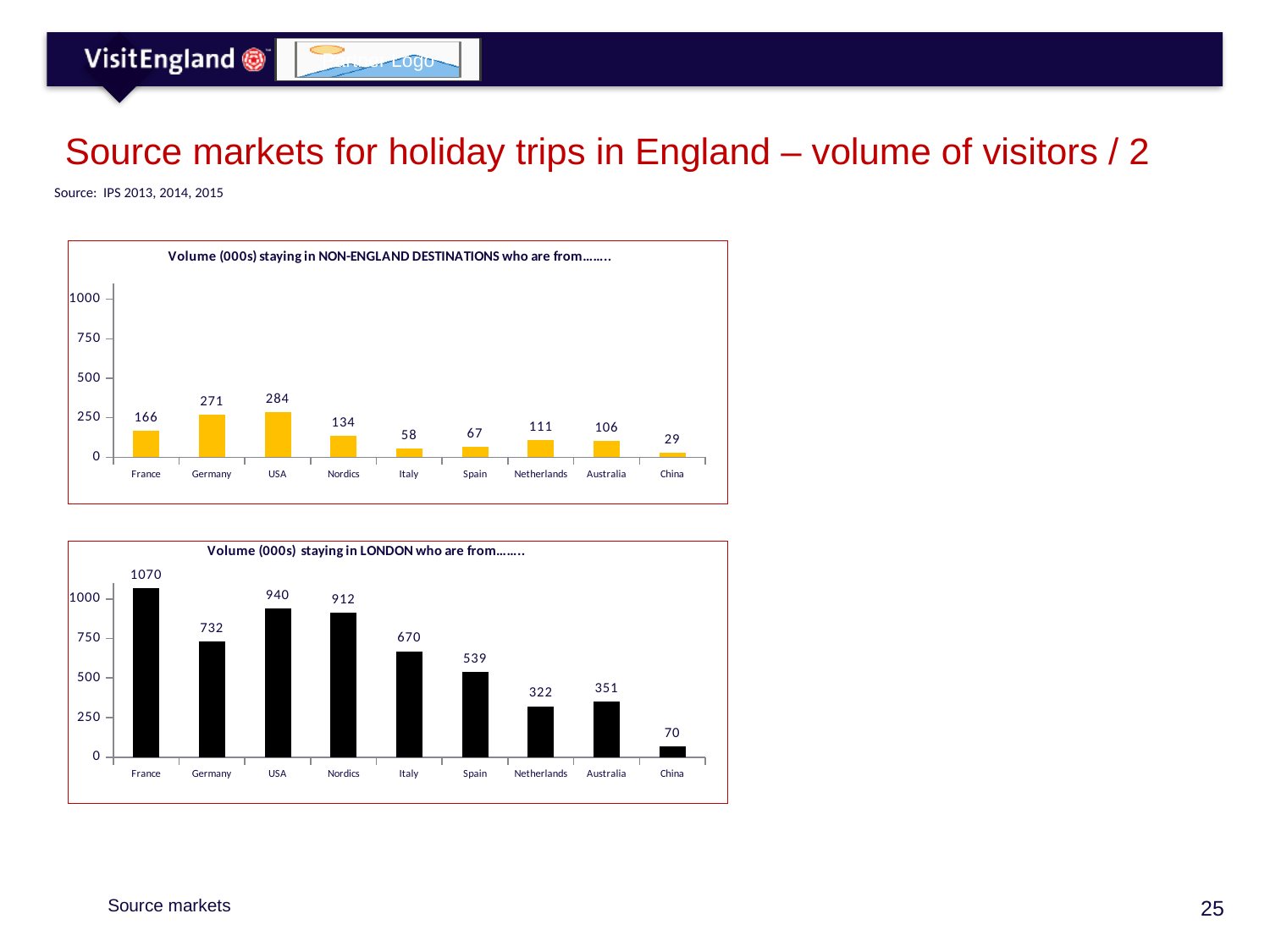
In the 'Volume (000s) staying in LONDON' chart, which country has the highest value? France How many countries are shown on the x axis of the 'Volume (000s) staying in LONDON' chart? 9 In the 'Volume (000s) staying in NON-ENGLAND DESTINATIONS' chart, what is the value for Germany? 271 In the 'Volume (000s) staying in LONDON' chart, what is the value for Italy? 670 In the 'Volume (000s) staying in LONDON' chart, which country has the lowest value? China In the 'Volume (000s) staying in NON-ENGLAND DESTINATIONS' chart, what is the difference between the values for USA and France? 118 In the 'Volume (000s) staying in LONDON' chart, is the value for Nordics greater or less than 750? greater In the 'Volume (000s) staying in NON-ENGLAND DESTINATIONS' chart, which is larger, the value for Netherlands or the value for Australia? Netherlands In the 'Volume (000s) staying in NON-ENGLAND DESTINATIONS' chart, which country has the highest value? USA What type of chart is the 'Volume (000s) staying in NON-ENGLAND DESTINATIONS' chart? Bar chart What colour are the bars in the 'Volume (000s) staying in LONDON' chart? Black In the 'Volume (000s) staying in LONDON' chart, what is the difference between the values for Germany and Spain? 193